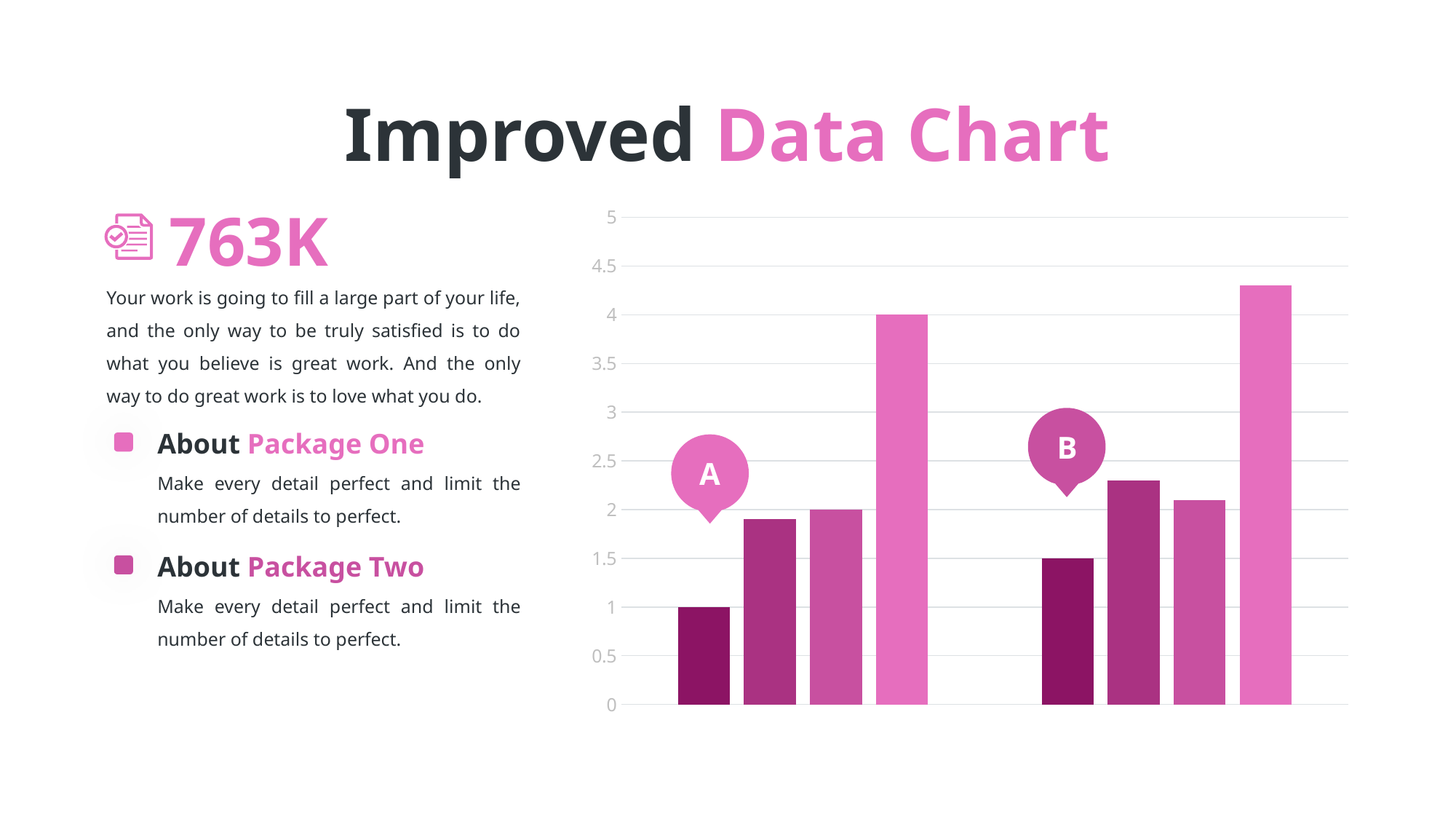
What is the highest value shown on the vertical axis? 5 Is the value of the first (darkest) bar in group B greater or less than 2? less How many labelled groups of bars does the chart show? 2 Which group has the taller fourth (lightest) bar, A or B? B What kind of chart is shown on the slide? bar chart What is the difference between the tallest and shortest bars in group A? 3 Which bar in group B is the lowest? the first (darkest) bar Is the value of the tallest bar in group B greater or less than 4? greater What is the value of the tallest bar in group A? 4 How many bars are in group A? 4 What is the value of the third bar in group A? 2 What is the value of the first (darkest) bar in group A? 1